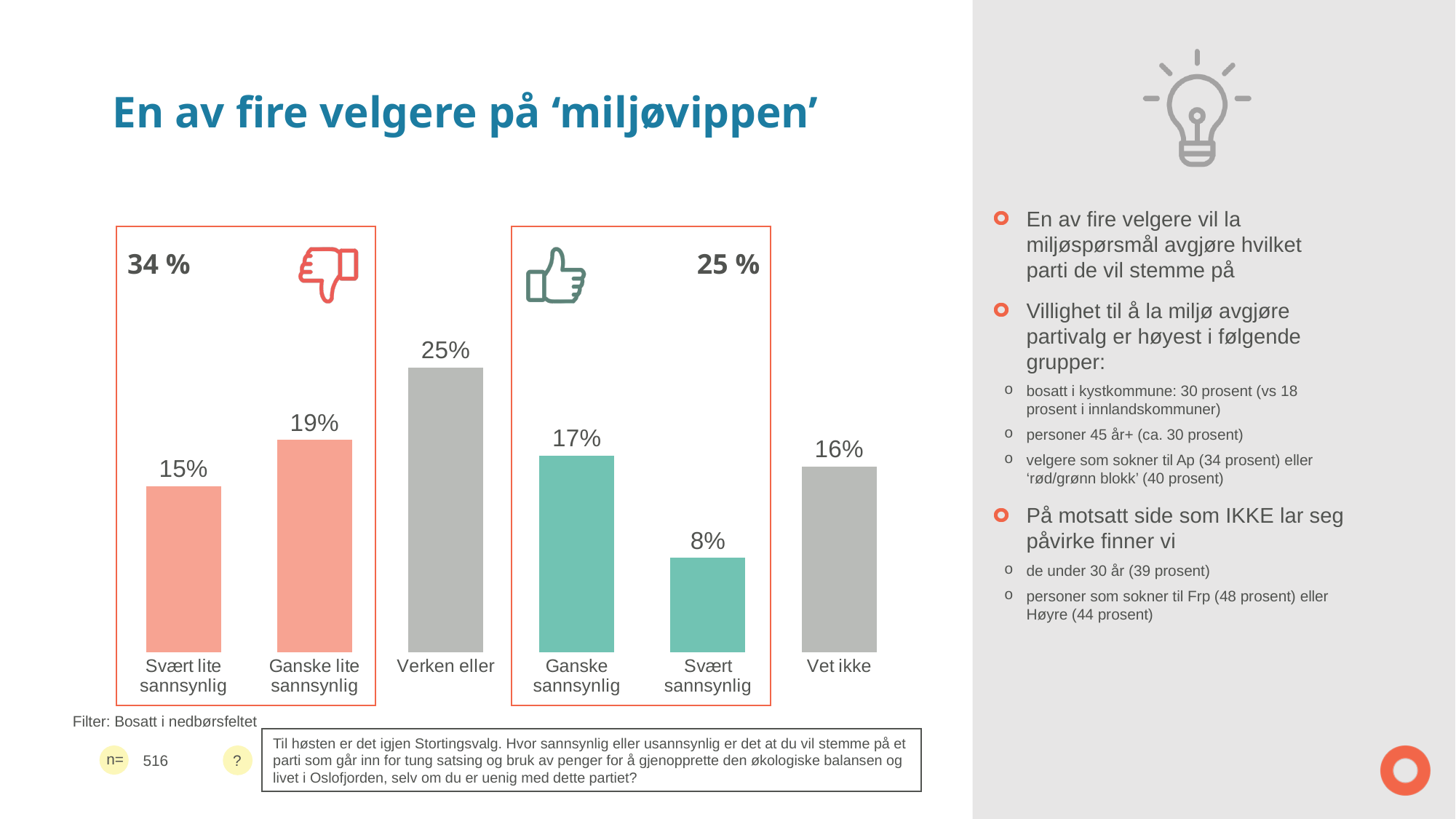
What is the value for 'Verken eller'? 25% Which category has the highest value? Verken eller How many categories are shown in the chart? 6 What combined percentage is shown in the box with the thumbs-up icon? 25 % Which is larger, 'Ganske sannsynlig' or 'Vet ikke'? Ganske sannsynlig What combined percentage is shown in the box with the thumbs-down icon? 34 % What kind of chart is shown on the slide? Bar chart What is the value for 'Ganske lite sannsynlig'? 19% What is the value for 'Svært sannsynlig'? 8% What is the value for 'Vet ikke'? 16% What is the difference between 'Ganske lite sannsynlig' and 'Svært lite sannsynlig'? 4% Which category has the lowest value? Svært sannsynlig